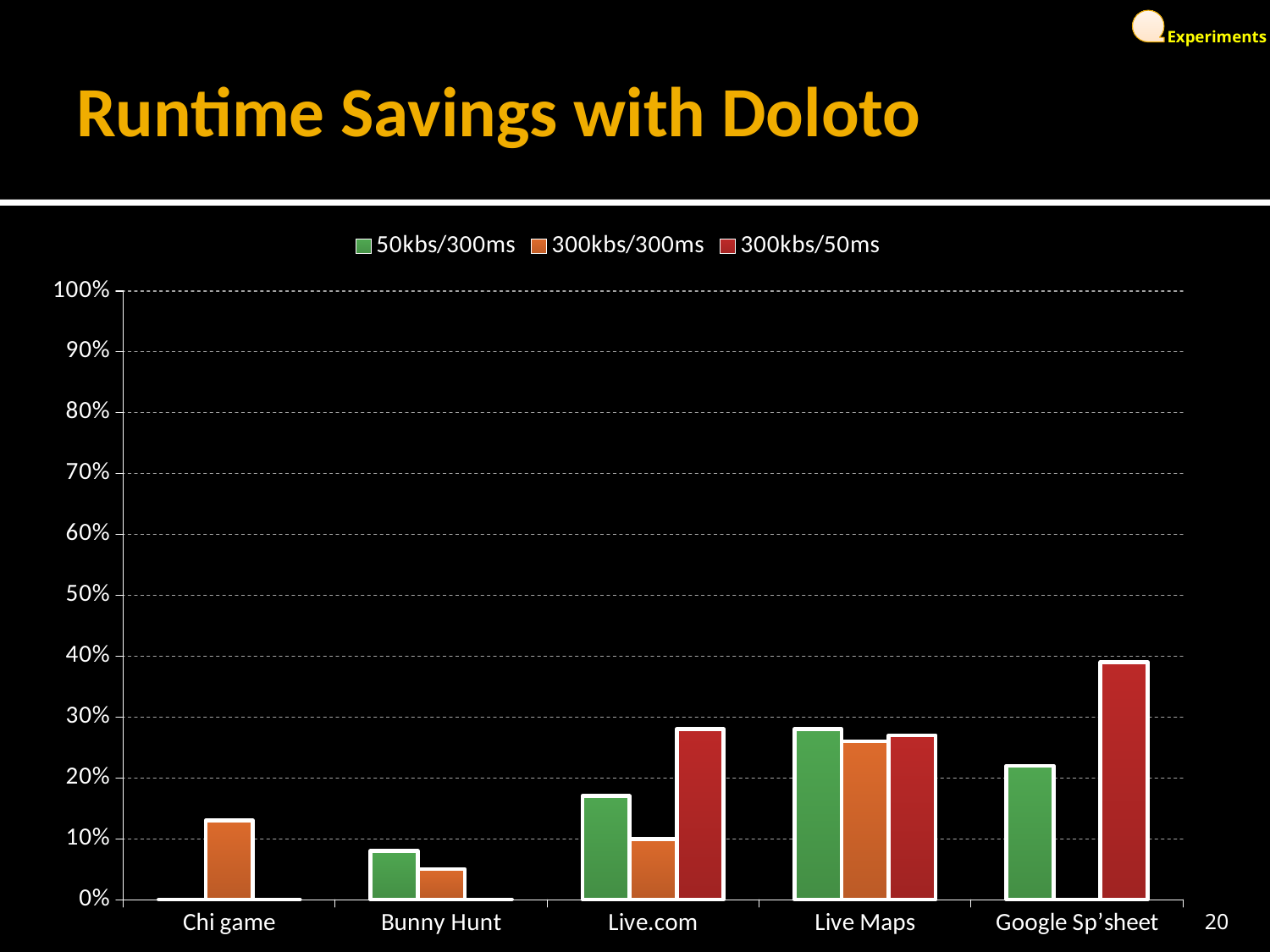
What kind of chart is shown on the slide? bar chart What is the title of the slide containing the chart? Runtime Savings with Doloto Which category has the highest bar for the 300kbs/50ms series? Google Sp'sheet How many series does the legend list? 3 For Live.com, which is larger: the 300kbs/50ms value or the 300kbs/300ms value? 300kbs/50ms Which category has the highest bar for the 50kbs/300ms series? Live Maps For Bunny Hunt, which is larger: the 50kbs/300ms value or the 300kbs/300ms value? 50kbs/300ms Is the value for Chi game in the 300kbs/300ms series greater or less than 20%? less Which category has the highest bar for the 300kbs/300ms series? Live Maps How many categories are shown on the x axis? 5 Is the value for Live.com in the 50kbs/300ms series greater or less than 10%? greater Is the value for Google Sp'sheet in the 300kbs/50ms series greater or less than 30%? greater